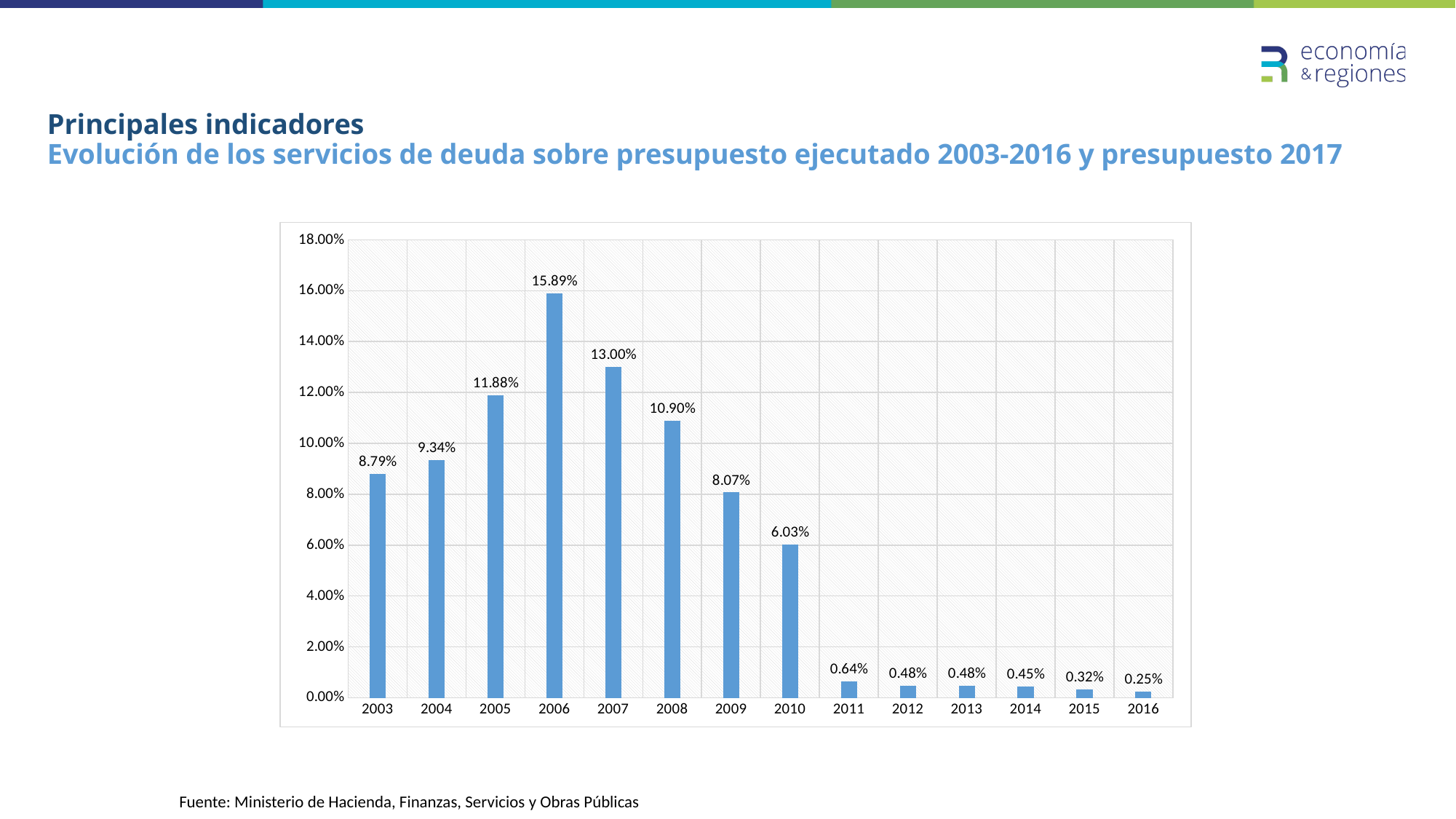
Is the value for 2008 greater or less than 10.00%? greater Which year has the lowest value? 2016 How many years are shown on the x axis? 14 What is the source cited below the chart? Ministerio de Hacienda, Finanzas, Servicios y Obras Públicas Which is larger, the value for 2004 or the value for 2009? 2004 What kind of chart is shown? bar chart What is the value for 2010? 6.03% What is the value for 2016? 0.25% Do the values rise or fall from 2006 to 2016? fall Which year has the highest value? 2006 What is the value for 2006? 15.89% What is the difference between the values for 2006 and 2007? 2.89%